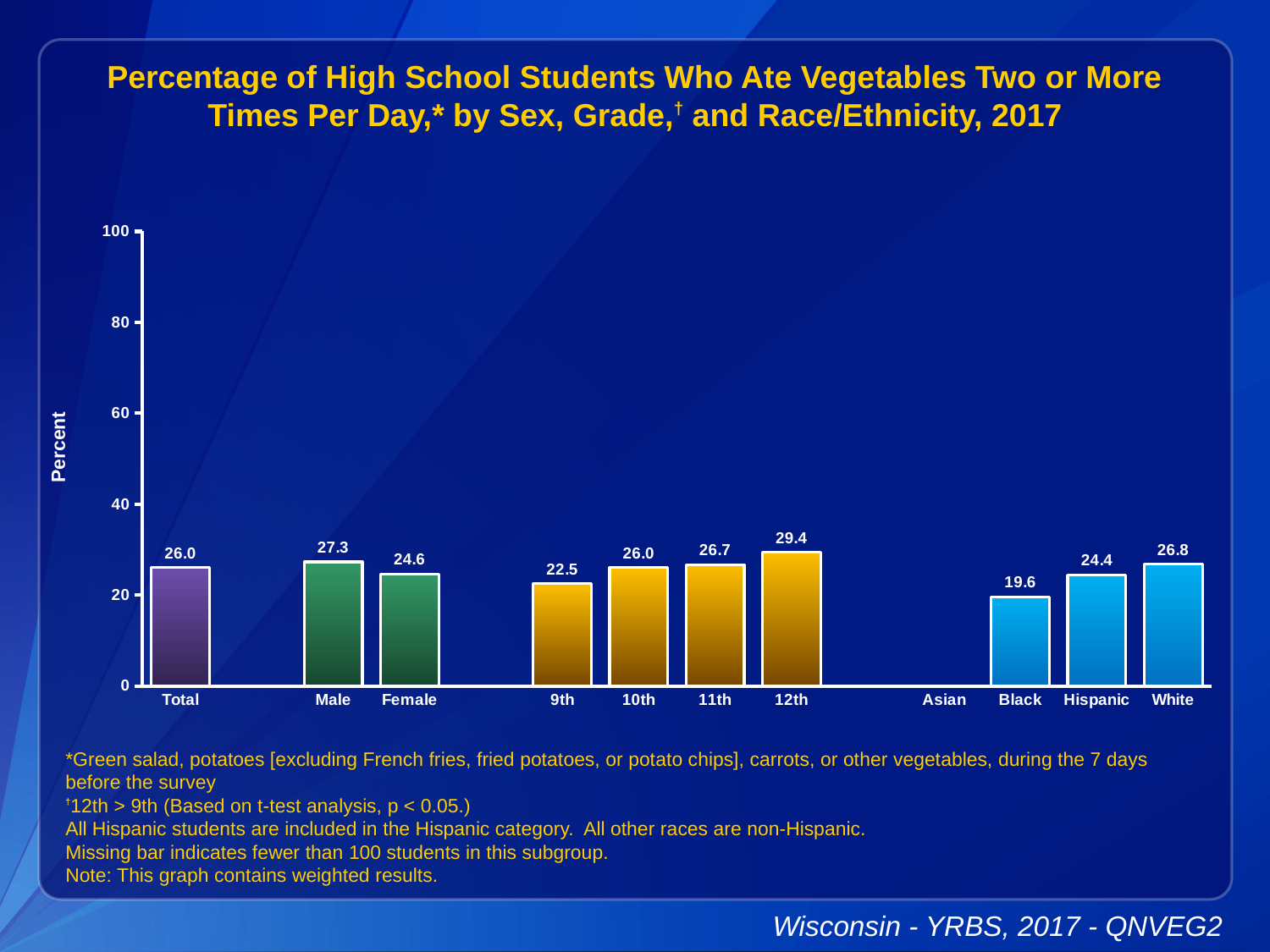
What is the value for Male? 27.3 What is the value for Black students? 19.6 What is the difference between the Male and Female values? 2.7 Which category on the x axis has no bar shown? Asian What kind of chart is shown? bar chart Which category has the highest value? 12th Which category with a bar has the lowest value? Black What is the difference between the 12th and 9th grade values? 6.9 Which is larger, the value for Hispanic or the value for White? White What is the value for 12th grade? 29.4 Is the value for 11th grade greater or less than 40? less What is the value for Total? 26.0